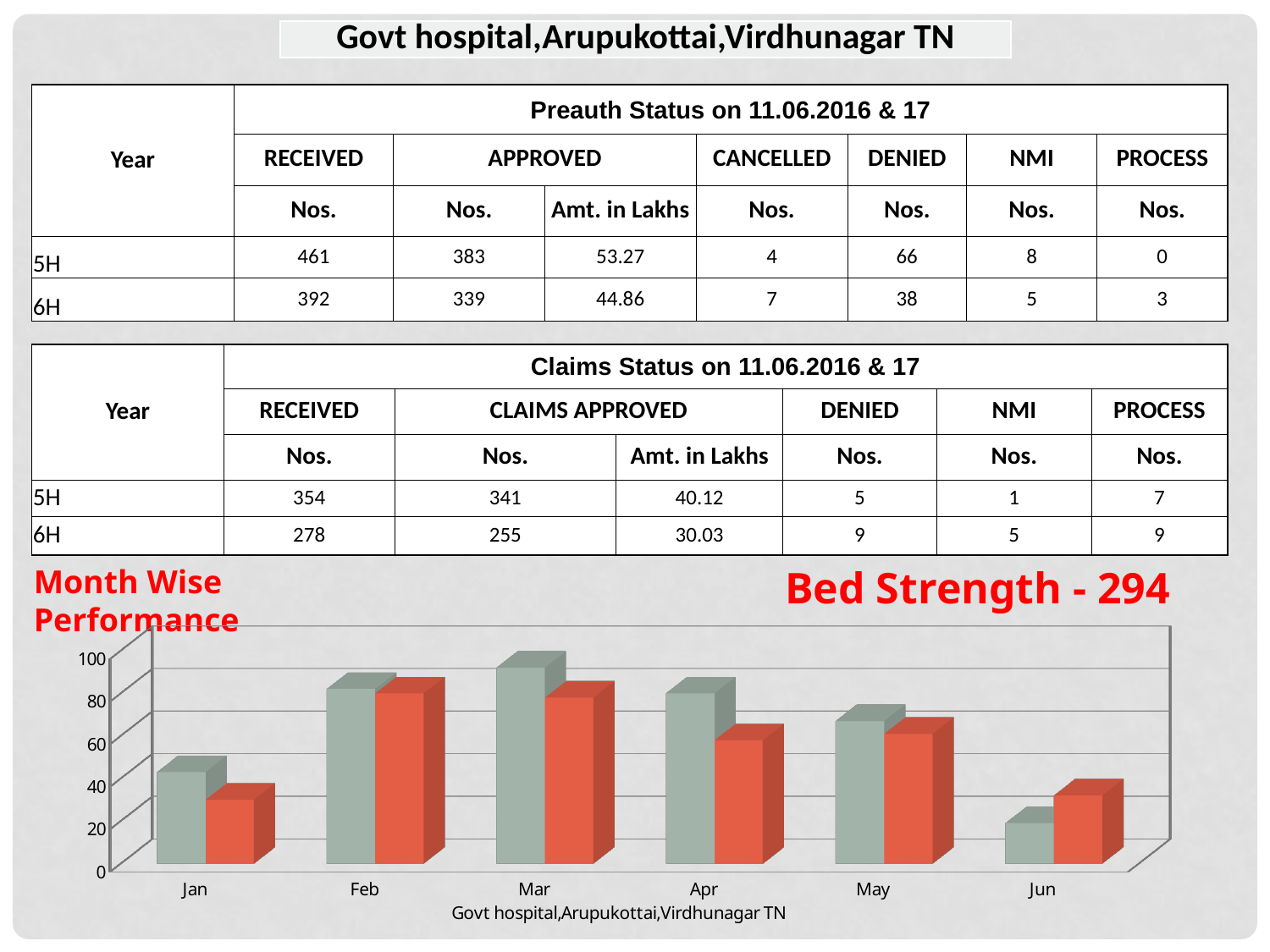
How many months are shown on the x axis of the bar chart? 6 In the bar chart, which month has the shortest grey-green (first) bar? Jun What kind of chart is shown at the bottom of the slide? bar chart In the bar chart, which bar is taller for Mar: the grey-green (first) bar or the red (second) bar? the grey-green (first) bar Do the grey-green (first) bars rise or fall from Mar to Jun? fall Is the red (second) bar for Apr greater or less than 40? greater What text appears as the axis title below the month labels of the bar chart? Govt hospital,Arupukottai,Virdhunagar TN Is the grey-green (first) bar for Mar greater or less than 80? greater In the bar chart, which month has the tallest grey-green (first) bar? Mar Is the red (second) bar for Jan greater or less than 40? less In the bar chart, which bar is taller for Jun: the grey-green (first) bar or the red (second) bar? the red (second) bar